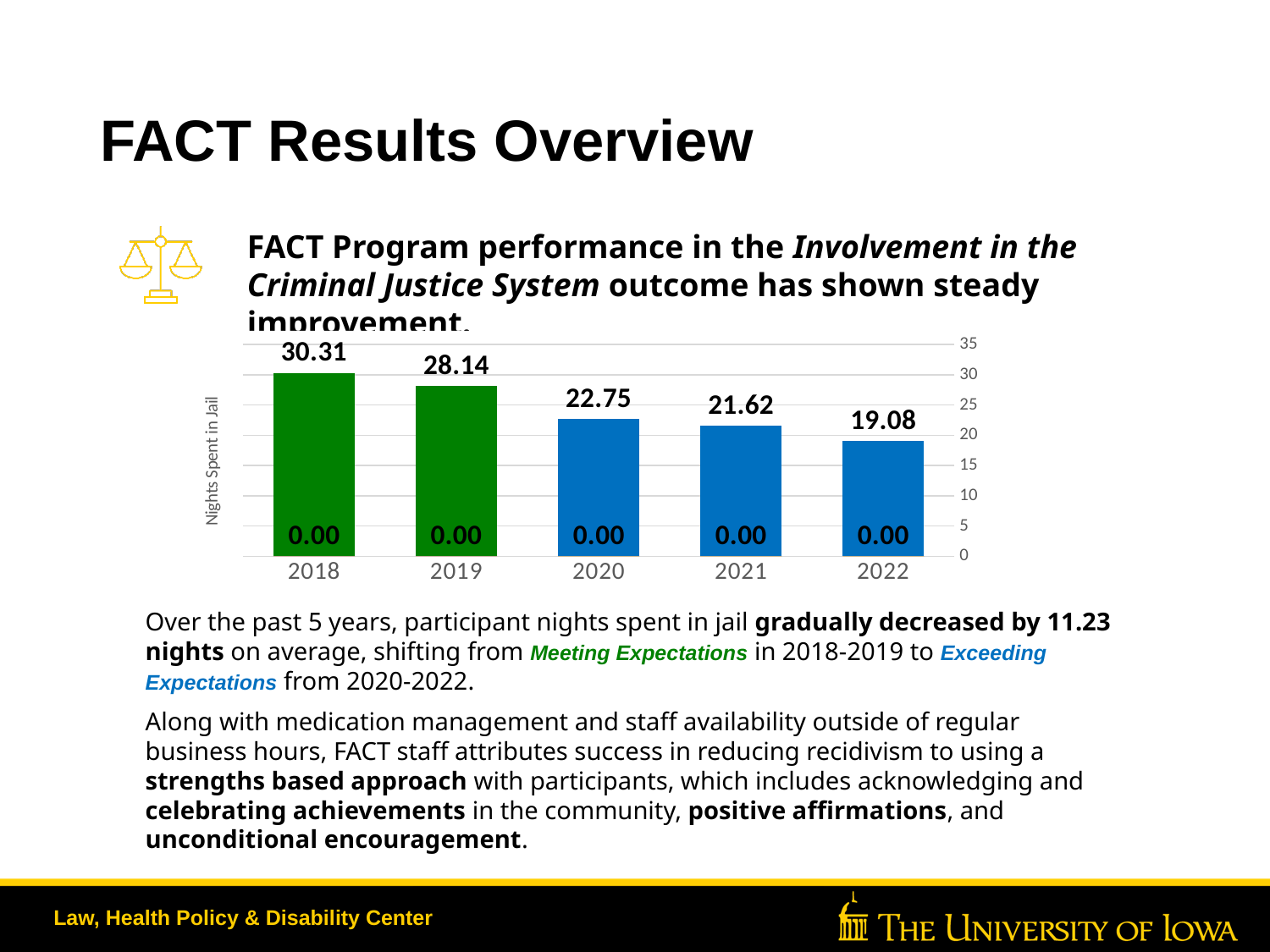
Which is larger in the Nights Spent in Jail chart, the value for 2019 or the value for 2021? 2019 What is the value for 2018 in the Nights Spent in Jail chart? 30.31 What kind of chart is used to show Nights Spent in Jail? Bar chart Which year has the highest value in the Nights Spent in Jail chart? 2018 What is the value for 2020 in the Nights Spent in Jail chart? 22.75 Which year has the lowest value in the Nights Spent in Jail chart? 2022 What colour are the bars for 2018 and 2019 in the Nights Spent in Jail chart? Green How many years are shown on the x axis of the Nights Spent in Jail chart? 5 What is the difference between the 2019 and 2020 values in the Nights Spent in Jail chart? 5.39 What is the value for 2022 in the Nights Spent in Jail chart? 19.08 What is the difference between the 2018 and 2022 values in the Nights Spent in Jail chart? 11.23 Do the values in the Nights Spent in Jail chart rise or fall from 2018 to 2022? Fall